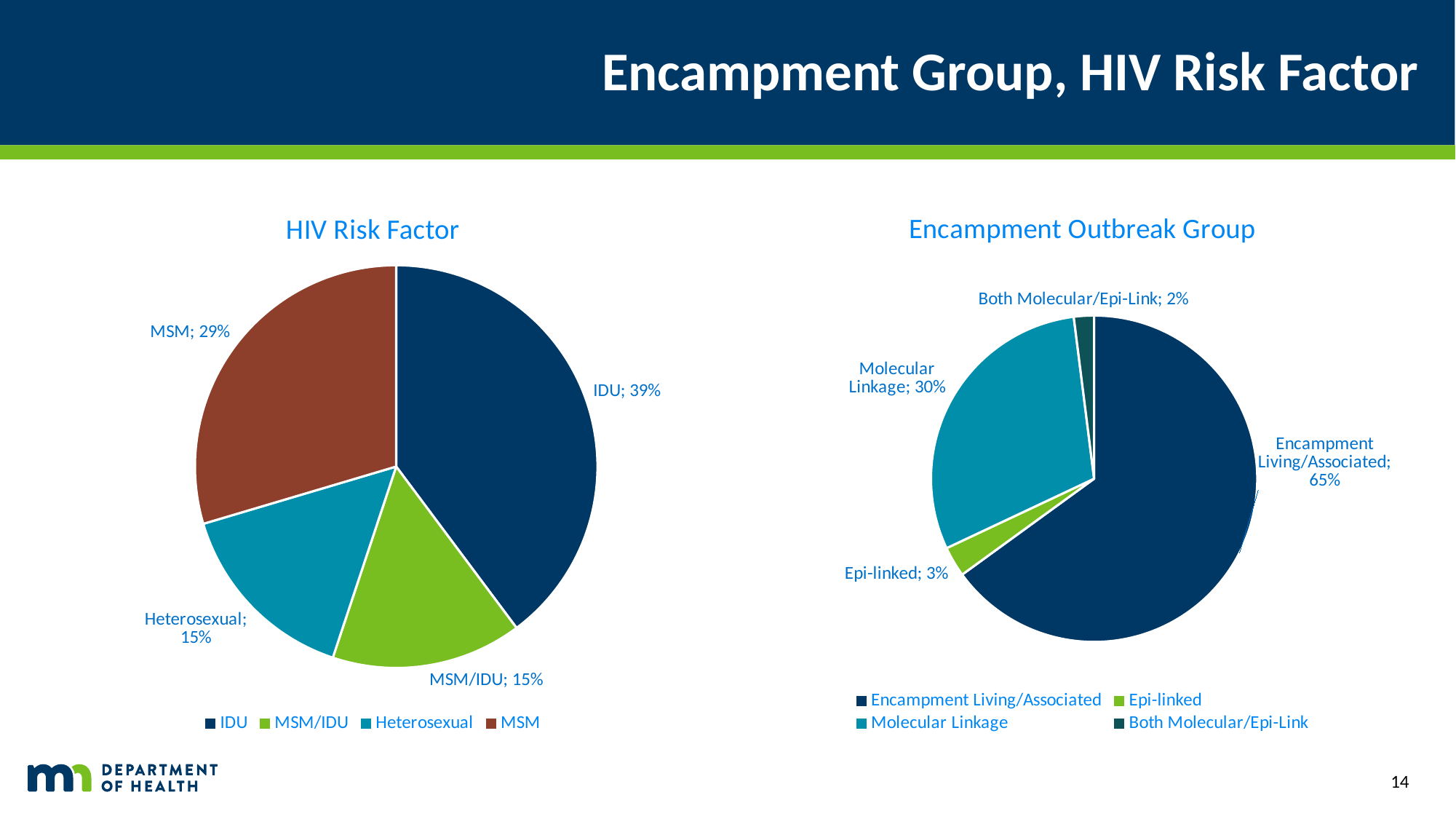
In the Encampment Outbreak Group chart, what share of the pie is Encampment Living/Associated? 65% In the Encampment Outbreak Group chart, which category has the smallest slice? Both Molecular/Epi-Link What colour is the MSM slice in the HIV Risk Factor chart? Brown In the HIV Risk Factor chart, what is the difference between the IDU and MSM shares? 10% In the HIV Risk Factor chart, how many categories does the legend list? 4 In the HIV Risk Factor chart, what share of the pie is IDU? 39% In the Encampment Outbreak Group chart, which is larger, Epi-linked or Both Molecular/Epi-Link? Epi-linked In the HIV Risk Factor chart, what share of the pie is MSM? 29% What kind of chart is the HIV Risk Factor chart? Pie chart In the Encampment Outbreak Group chart, what is the difference between the Encampment Living/Associated and Molecular Linkage shares? 35% In the HIV Risk Factor chart, which category has the largest slice? IDU